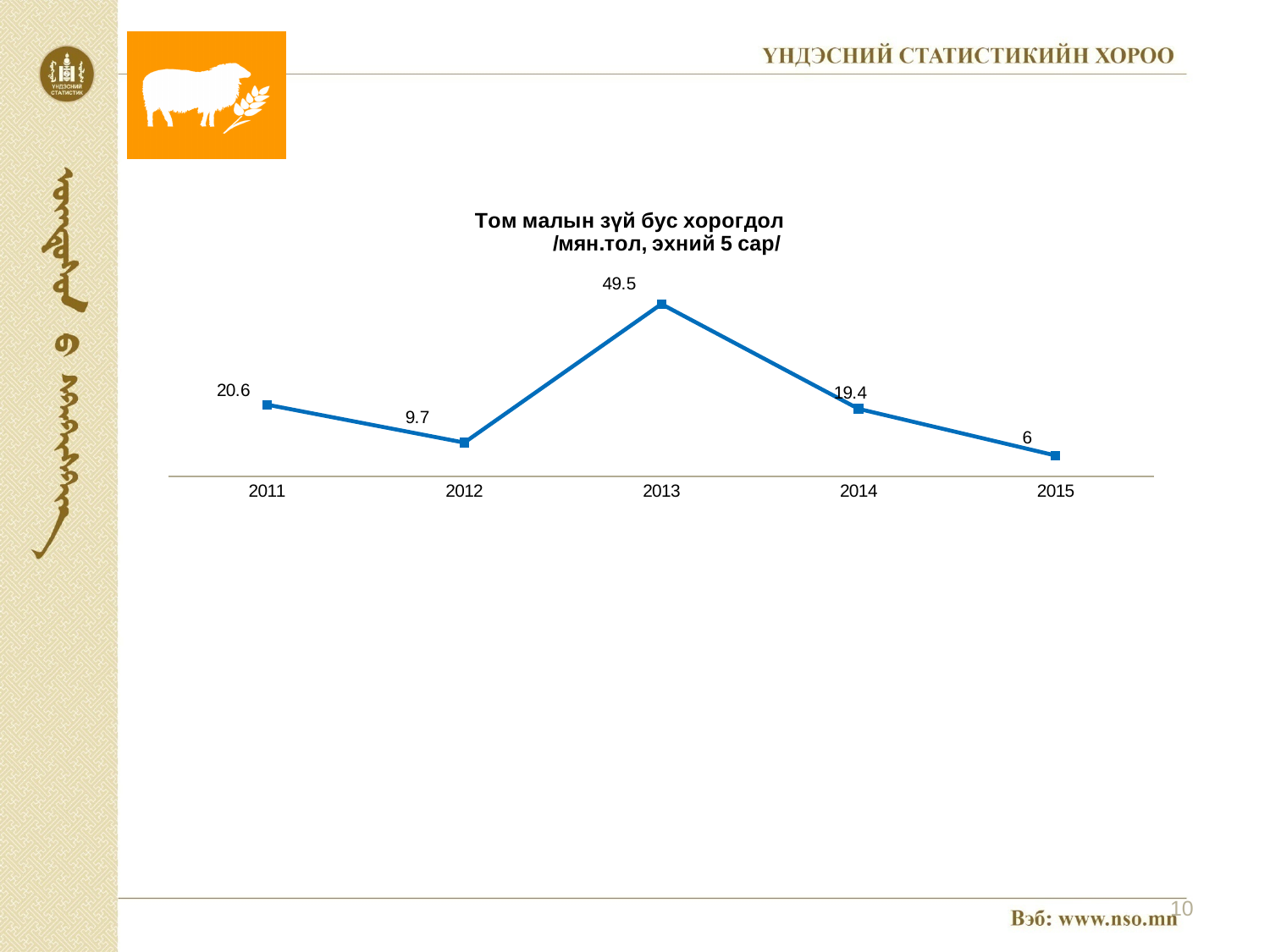
Which year has the lowest value? 2015 What is the value for 2011? 20.6 How many years are plotted on the chart? 5 What kind of chart is shown on the slide? line chart Does the value rise or fall from 2013 to 2015? fall What is the difference between the values for 2011 and 2014? 1.2 Which is larger, the value for 2012 or the value for 2014? 2014 What is the value for 2013? 49.5 What is the title of the chart? Том малын зүй бус хорогдол /мян.тол, эхний 5 сар/ What is the value for 2015? 6 What is the difference between the values for 2013 and 2012? 39.8 Which year has the highest value? 2013